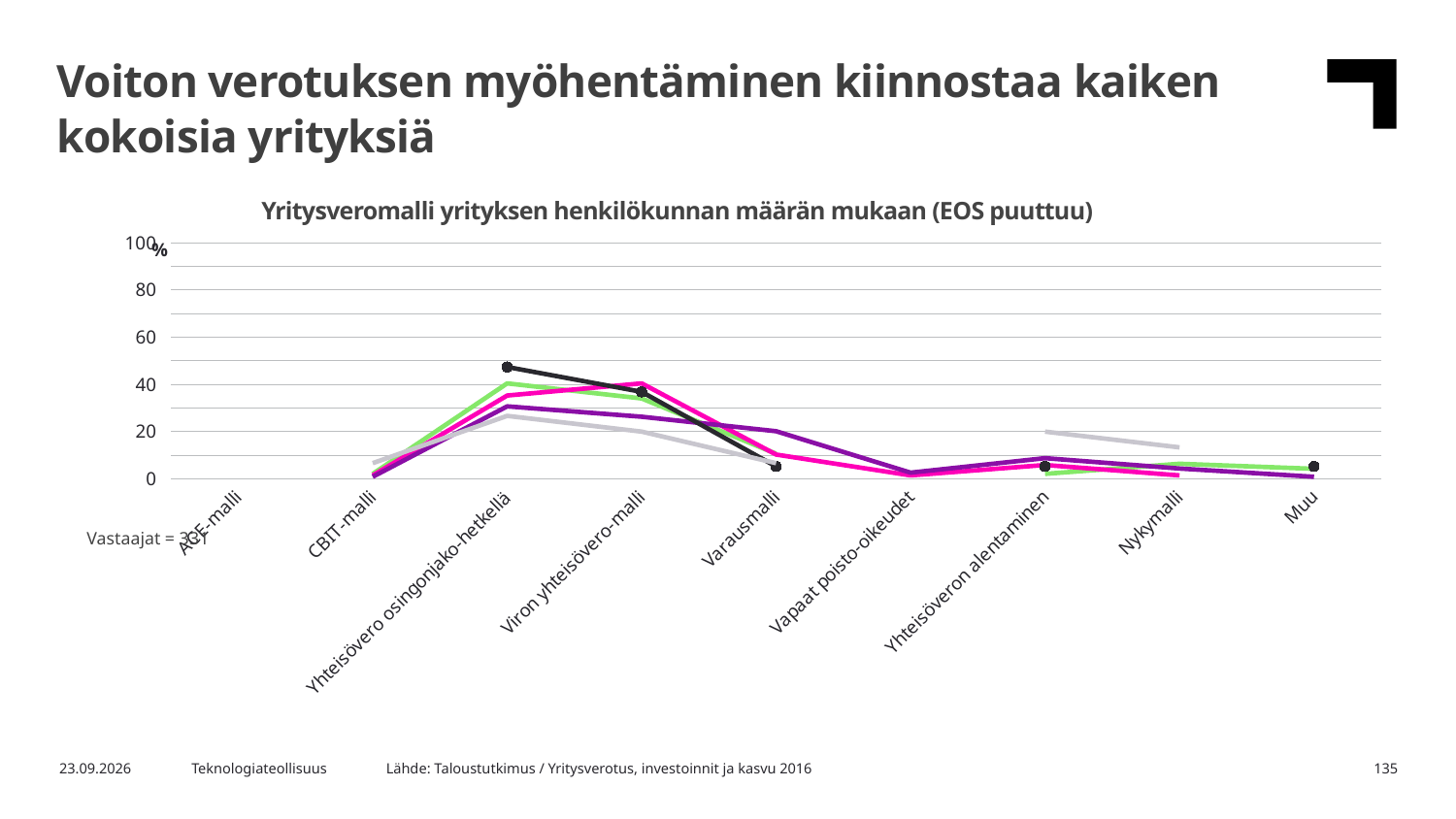
Do the lines rise or fall between CBIT-malli and Yhteisövero osingonjako-hetkellä? rise What is the maximum value shown on the y axis of the chart? 100 Is the highest plotted value at Nykymalli greater or less than 20? less Do the lines rise or fall between Viron yhteisövero-malli and Varausmalli? fall Is the highest plotted value at Vapaat poisto-oikeudet greater or less than 20? less What kind of chart is shown on the slide? line chart At which category does the chart reach its highest plotted value? Yhteisövero osingonjako-hetkellä Is the highest plotted value at Yhteisövero osingonjako-hetkellä greater or less than 40? greater How many categories are shown on the x axis of the chart? 9 What is the title of the chart? Yritysveromalli yrityksen henkilökunnan määrän mukaan (EOS puuttuu)